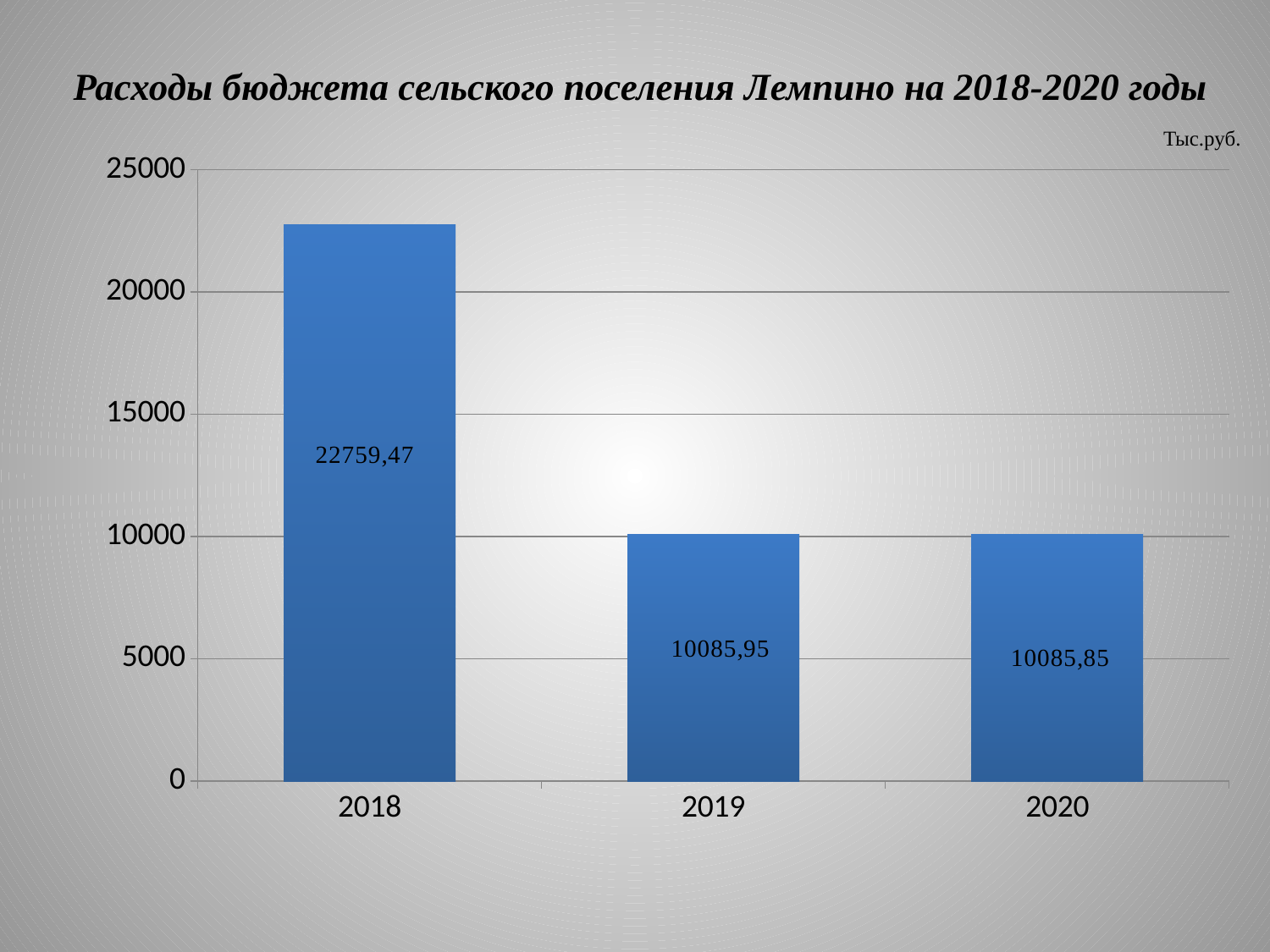
What is the difference between the 2018 and 2019 values? 12673,52 What is the difference between the 2019 and 2020 values? 0,10 What is the budget expenditure value shown for 2018? 22759,47 What is the budget expenditure value shown for 2020? 10085,85 What kind of chart is shown on the slide? bar chart Is the value for 2018 greater or less than 20000? greater In what units are the values on the chart expressed? Тыс.руб. Which is larger, the value for 2018 or the value for 2019? 2018 Is the value for 2020 greater or less than 15000? less How many years are shown on the chart? 3 Which year has the highest budget expenditure? 2018 What is the budget expenditure value shown for 2019? 10085,95